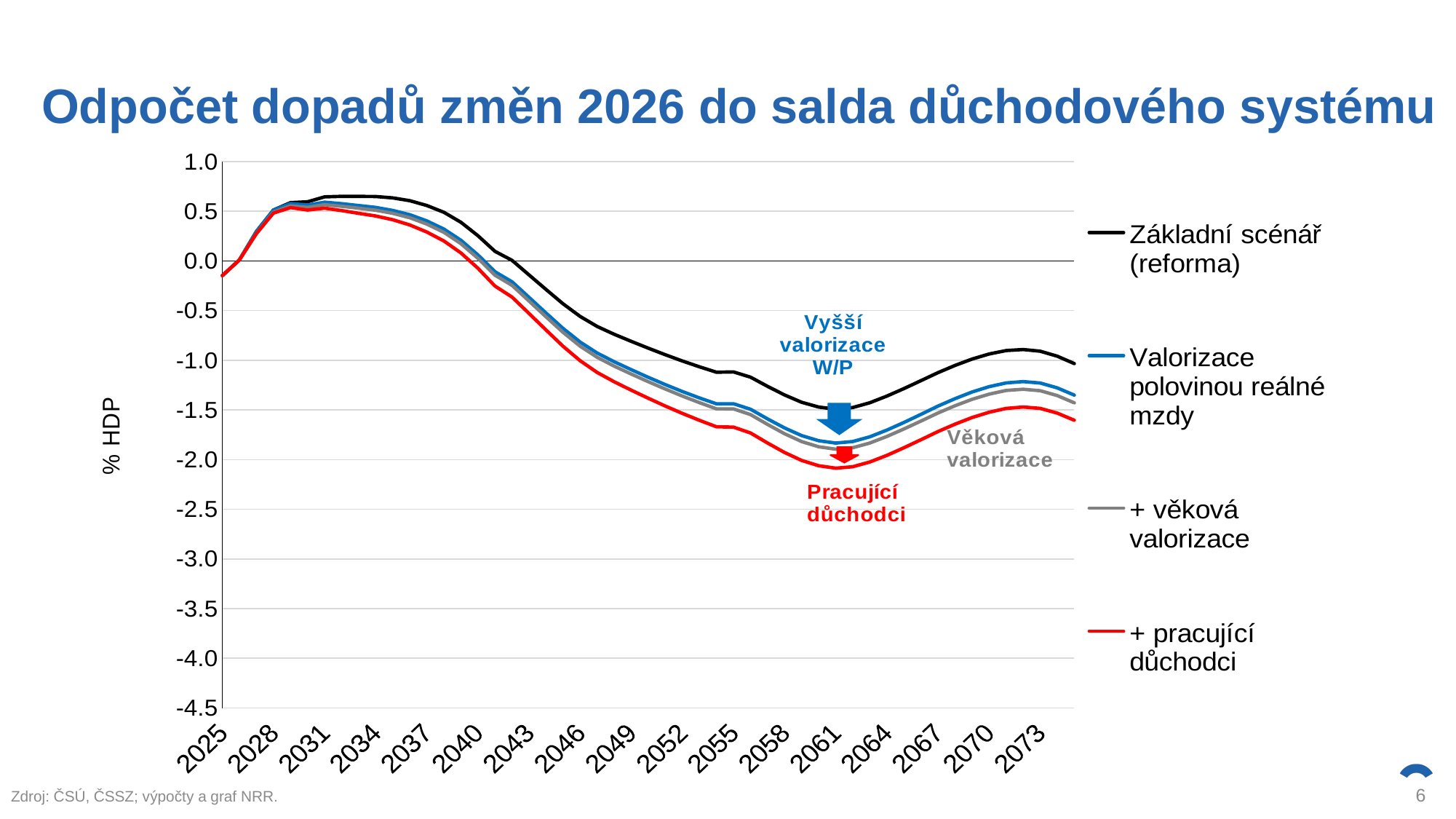
Which series has the lowest values around 2061? + pracující důchodci What is the label of the y axis? % HDP Is the value of Základní scénář (reforma) in 2034 greater or less than 0.5? greater Which series has the highest values around 2061? Základní scénář (reforma) How many series does the legend list? 4 Is the value of + pracující důchodci in 2055 greater or less than -1.5? less Do the values of Základní scénář (reforma) rise or fall between 2034 and 2061? fall Which series is drawn in red according to the legend? + pracující důchodci In 2073, which is larger: the value of Valorizace polovinou reálné mzdy or the value of + pracující důchodci? Valorizace polovinou reálné mzdy Is the value of Valorizace polovinou reálné mzdy in 2073 greater or less than -1.0? less How many year labels are shown on the x axis? 17 What kind of chart is shown on the slide? line chart